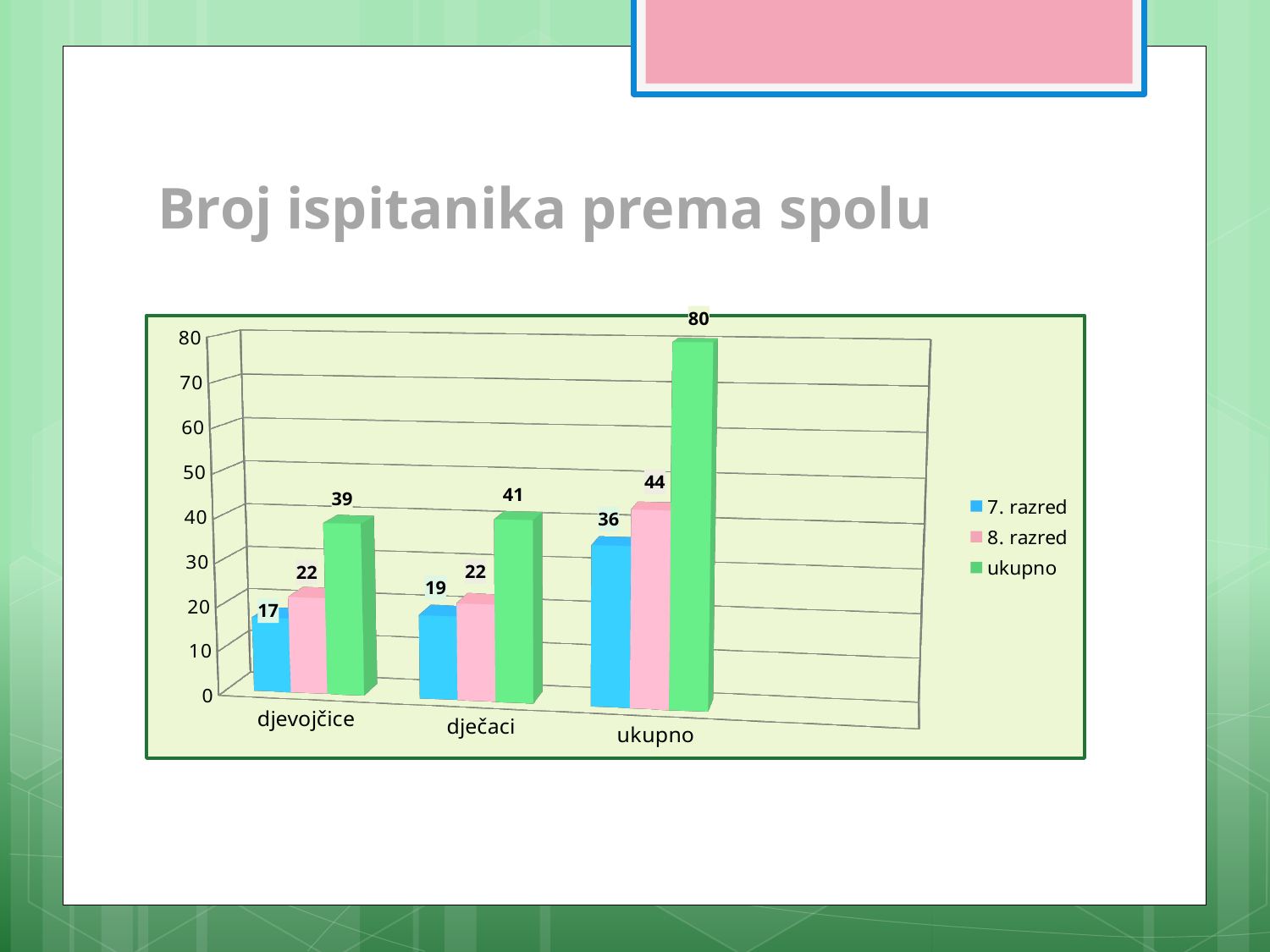
What kind of chart is shown on the slide? bar chart Which category has the highest value for the ukupno series? ukupno What is the value for 7. razred in the ukupno category? 36 Which category has the lowest value for the 7. razred series? djevojčice What is the difference between the ukupno values for dječaci and djevojčice? 2 How many categories are shown on the x axis? 3 What is the value for ukupno in the ukupno category? 80 Which is larger: the 8. razred value for ukupno or the 7. razred value for ukupno? 8. razred What is the title of the slide? Broj ispitanika prema spolu What is the value for 7. razred in the djevojčice category? 17 What is the value for 8. razred in the dječaci category? 22 How many series does the legend list? 3